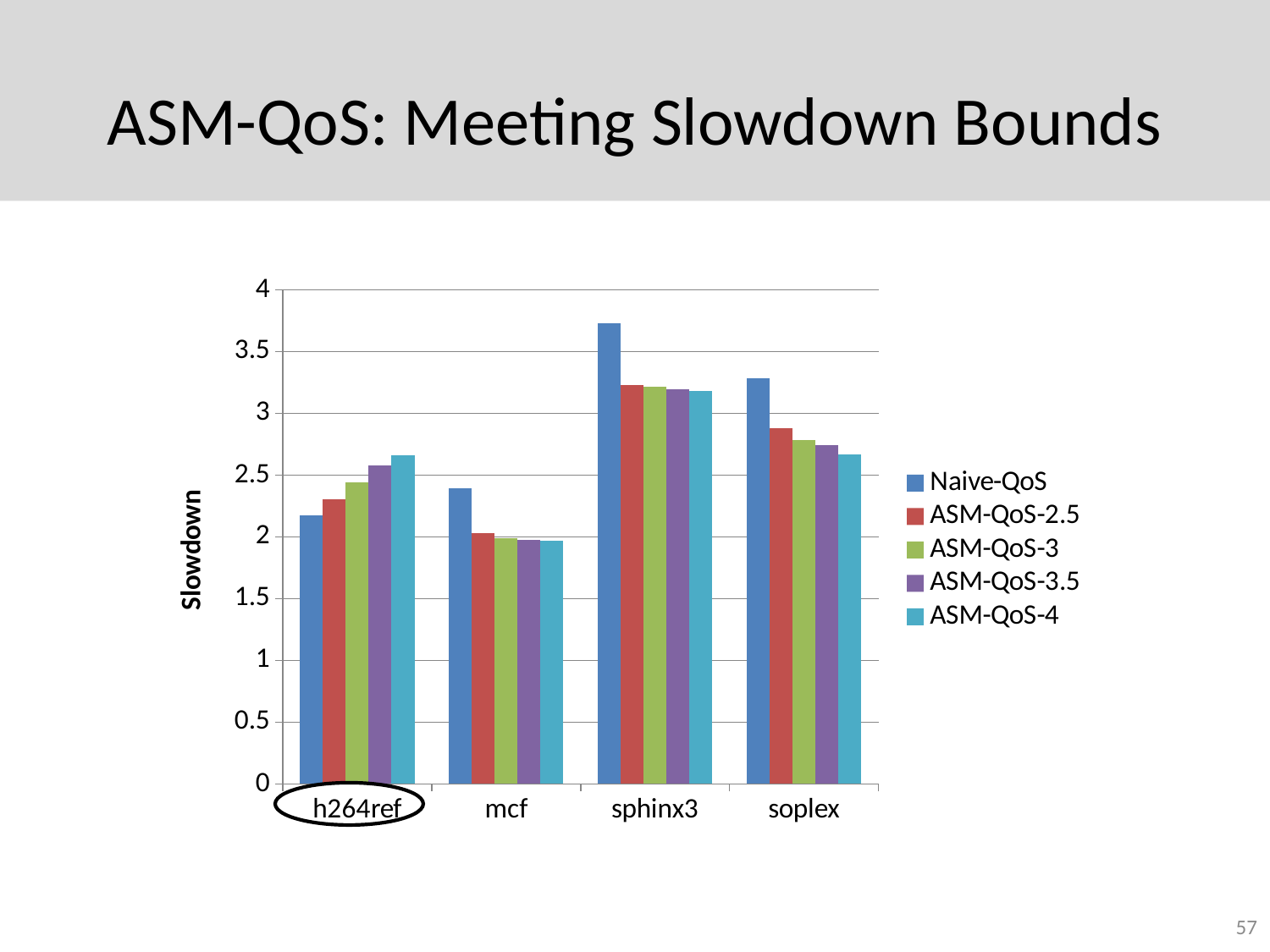
Which is larger, the ASM-QoS-4 value for sphinx3 or for soplex? sphinx3 Which benchmark has the lowest Naive-QoS slowdown? h264ref What is the label on the y axis? Slowdown Which benchmark has the highest Naive-QoS slowdown? sphinx3 How many series does the legend list? 5 Is the Naive-QoS value for sphinx3 greater or less than 3.5? greater Is the Naive-QoS value for soplex greater or less than 3? greater How many benchmark categories are shown on the x axis? 4 Which is larger, the Naive-QoS value for mcf or for h264ref? mcf What kind of chart is shown on the slide? bar chart Is the ASM-QoS-2.5 value for mcf greater or less than 2.5? less For h264ref, do the bars rise or fall going from Naive-QoS to ASM-QoS-4? rise